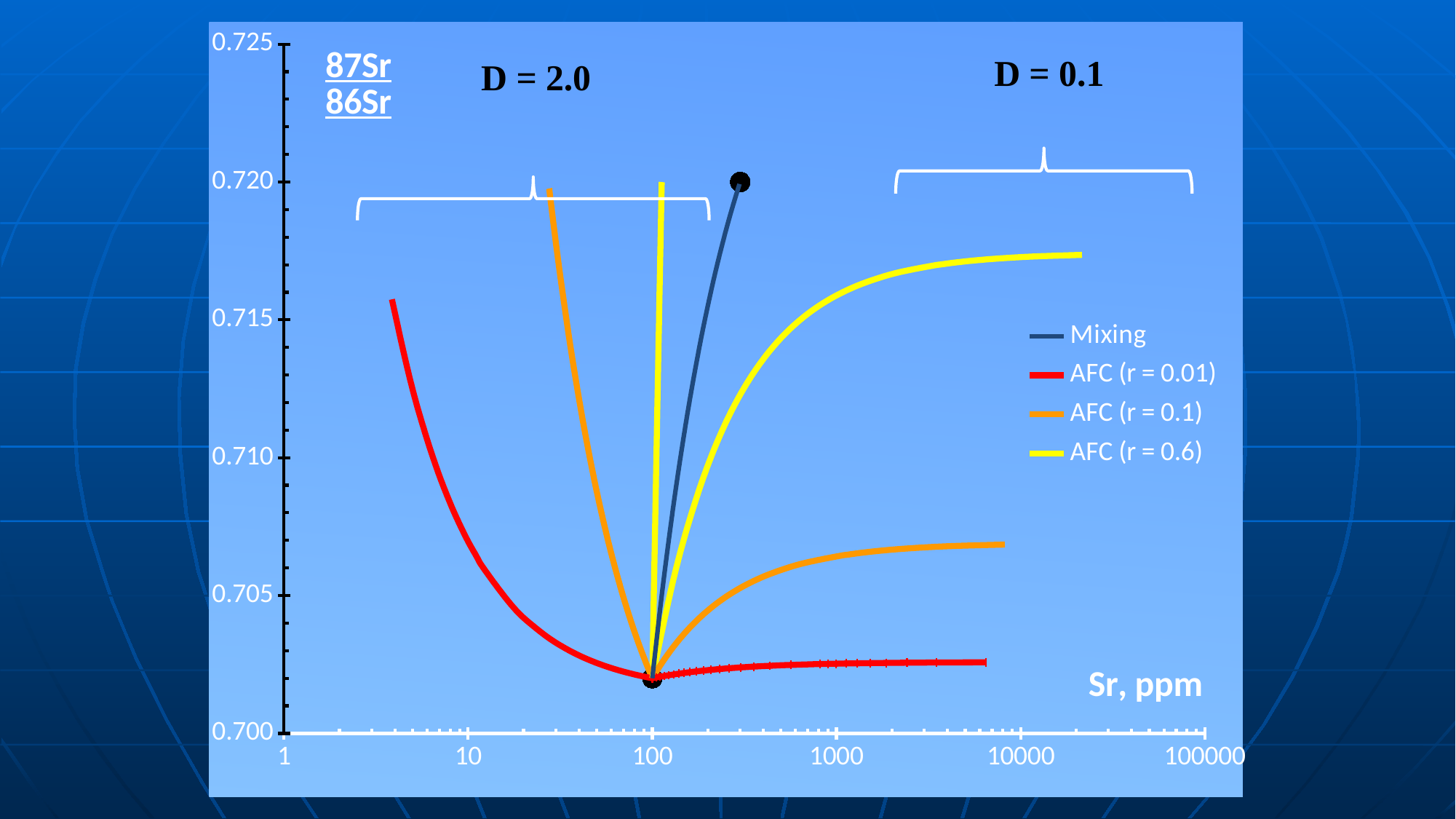
What kind of chart is shown on the slide? line chart Is the value of the AFC (r = 0.01) curve at Sr = 1000 ppm greater or less than 0.705? less Which colour is used for the AFC (r = 0.1) series? orange At Sr = 10000 ppm, which is larger: the AFC (r = 0.6) value or the AFC (r = 0.1) value? AFC (r = 0.6) Is the value of the AFC (r = 0.01) curve at Sr = 10 ppm greater or less than 0.705? greater Which series reaches the highest 87Sr/86Sr value on the right-hand (high Sr) side of the chart? AFC (r = 0.6) Does the AFC (r = 0.01) curve rise or fall as Sr increases from about 4 ppm to 100 ppm? fall Which series has the lowest 87Sr/86Sr value on the right-hand (high Sr) side of the chart? AFC (r = 0.01) How many series does the legend list? 4 Is the value of the AFC (r = 0.6) curve at Sr = 10000 ppm greater or less than 0.715? greater What is the label of the x axis? Sr, ppm